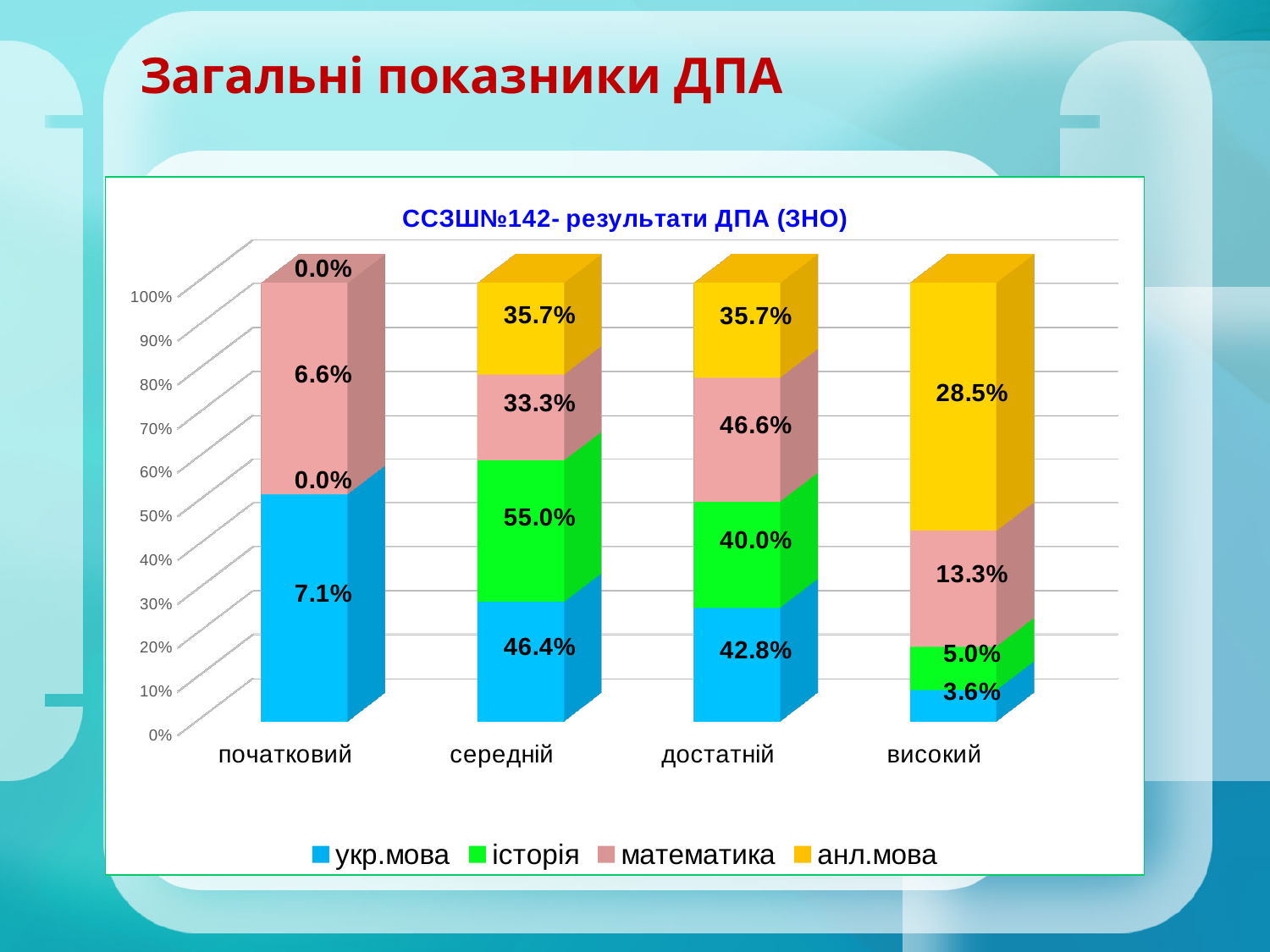
How many categories are shown on the x axis? 4 In which category is the value for історія highest? середній What kind of chart is shown on the slide? stacked bar chart What is the title of the chart? ССЗШ№142- результати ДПА (ЗНО) What is the difference between the математика values for достатній and середній? 13.3% How many series does the legend list? 4 What is the value for укр.мова in the середній category? 46.4% What is the value for анл.мова in the високий category? 28.5% In which category is the value for укр.мова lowest? високий What is the value for математика in the достатній category? 46.6% What is the value for історія in the початковий category? 0.0% Which is larger in the достатній category: укр.мова or історія? укр.мова